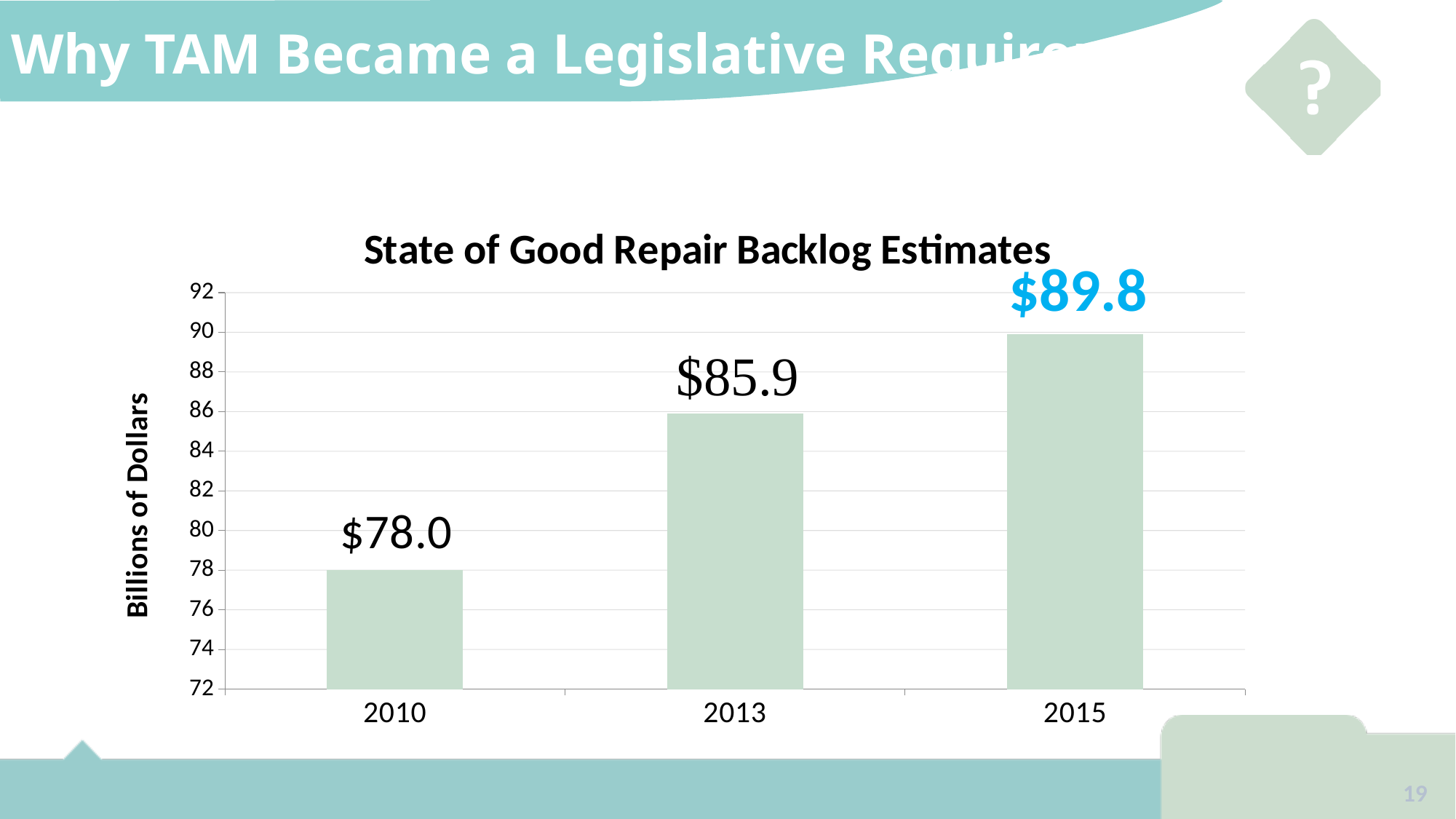
Do the backlog estimates rise or fall from 2010 to 2015? Rise Which year has the lowest backlog estimate? 2010 Which year has the highest backlog estimate? 2015 How many years are shown on the chart? 3 Is the value for 2013 greater or less than 84? greater What is the State of Good Repair backlog estimate for 2013? $85.9 What is the State of Good Repair backlog estimate for 2015? $89.8 What is the State of Good Repair backlog estimate for 2010? $78.0 What kind of chart is shown on the slide? Bar chart Which year has a larger backlog estimate, 2013 or 2015? 2015 What is the difference between the 2015 and 2010 backlog estimates? $11.8 What is the difference between the 2013 and 2010 backlog estimates? $7.9